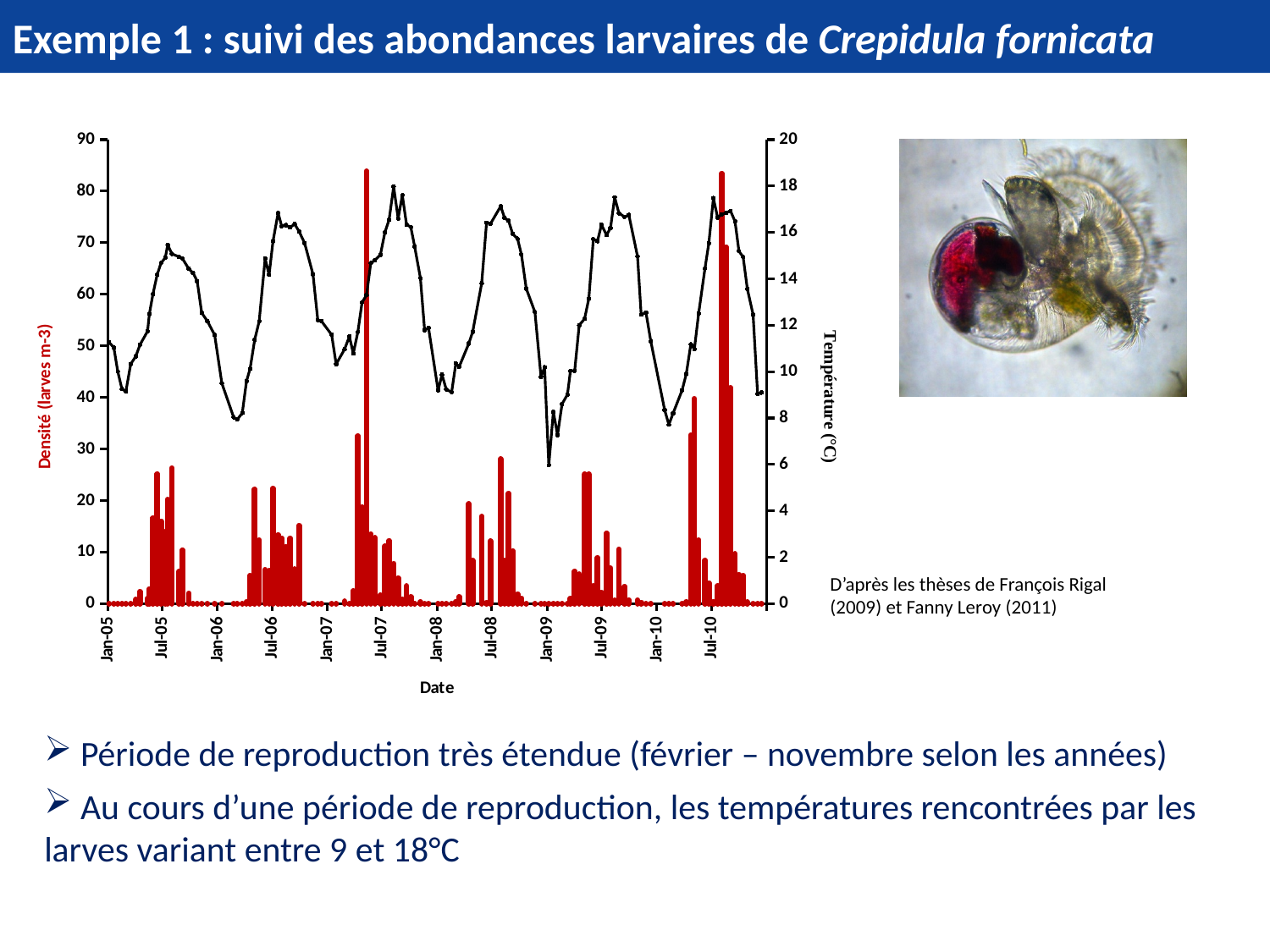
What is the label of the left vertical axis? Densité (larves m-3) What kind of chart is shown on the slide? A combined bar and line chart What is the maximum value shown on the right vertical axis? 20 Is the lowest point of the temperature line (around Jan-09) greater or less than 8°C? less What is the label of the right vertical axis? Température (°C) What is the first date label on the x axis? Jan-05 How many date labels are shown along the x axis? 12 Is the tallest red density bar greater or less than 80 larves m-3? greater What is the maximum value shown on the left vertical axis? 90 Is the temperature peak around Jul-07 greater or less than 16°C? greater Does the temperature line rise or fall between Jul-05 and Jan-06? fall